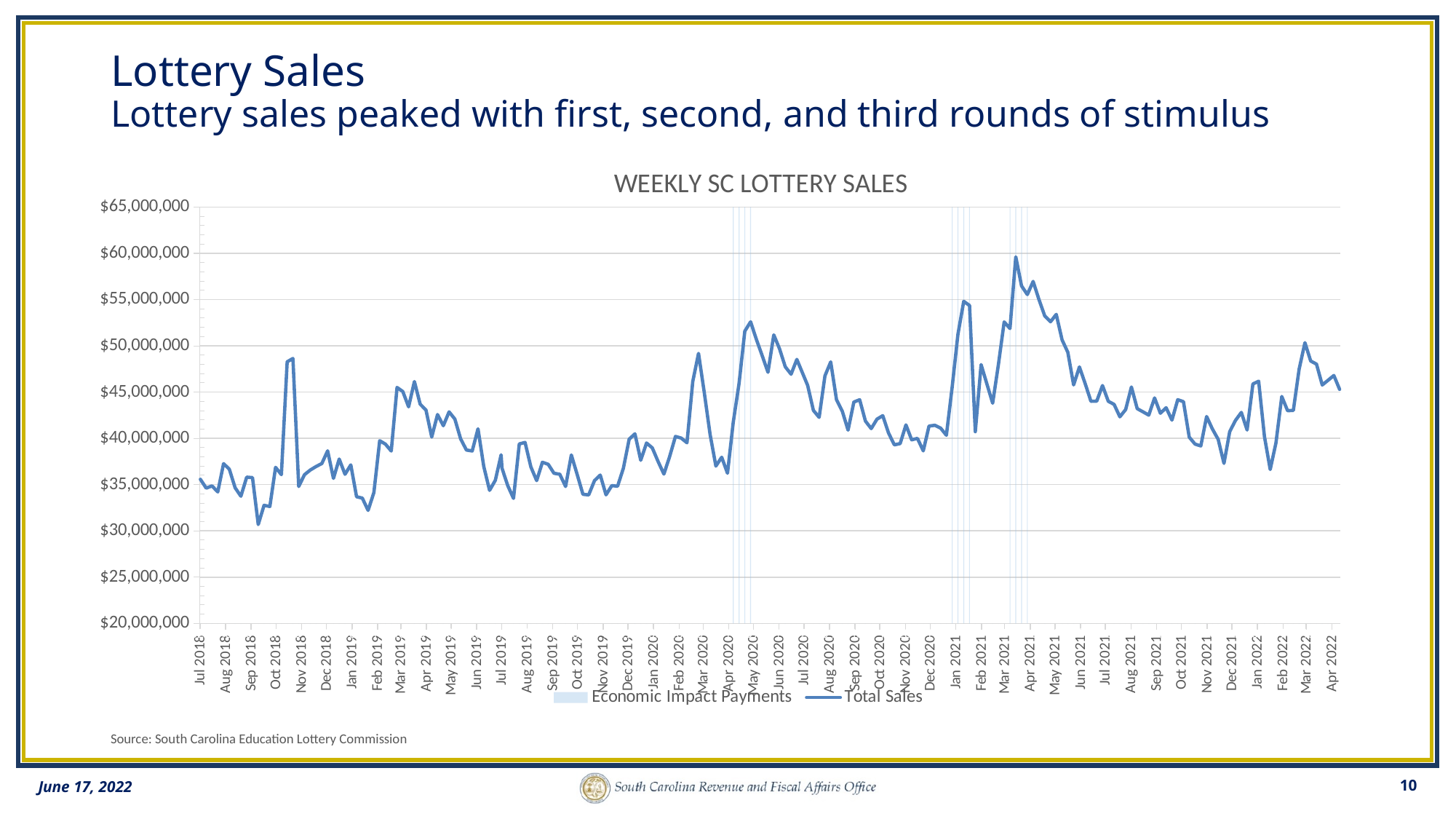
What is the title of the chart? WEEKLY SC LOTTERY SALES What is the highest value shown on the vertical axis? $65,000,000 What kind of chart is shown on the slide? Line chart Is the lowest weekly sales value, around Sep 2018, greater or less than $35,000,000? less Is the highest weekly sales value, reached around Mar 2021, greater or less than $55,000,000? greater Which peak is higher: the one around Mar 2021 or the one around Jan 2021? Mar 2021 Do weekly sales generally rise or fall between the Mar 2021 peak and Jan 2022? fall In which month does the Total Sales line reach its highest peak? Mar 2021 What are the two entries listed in the chart legend? Economic Impact Payments and Total Sales How many entries does the chart legend list? 2 Is the peak in weekly sales around May 2020 greater or less than $50,000,000? greater